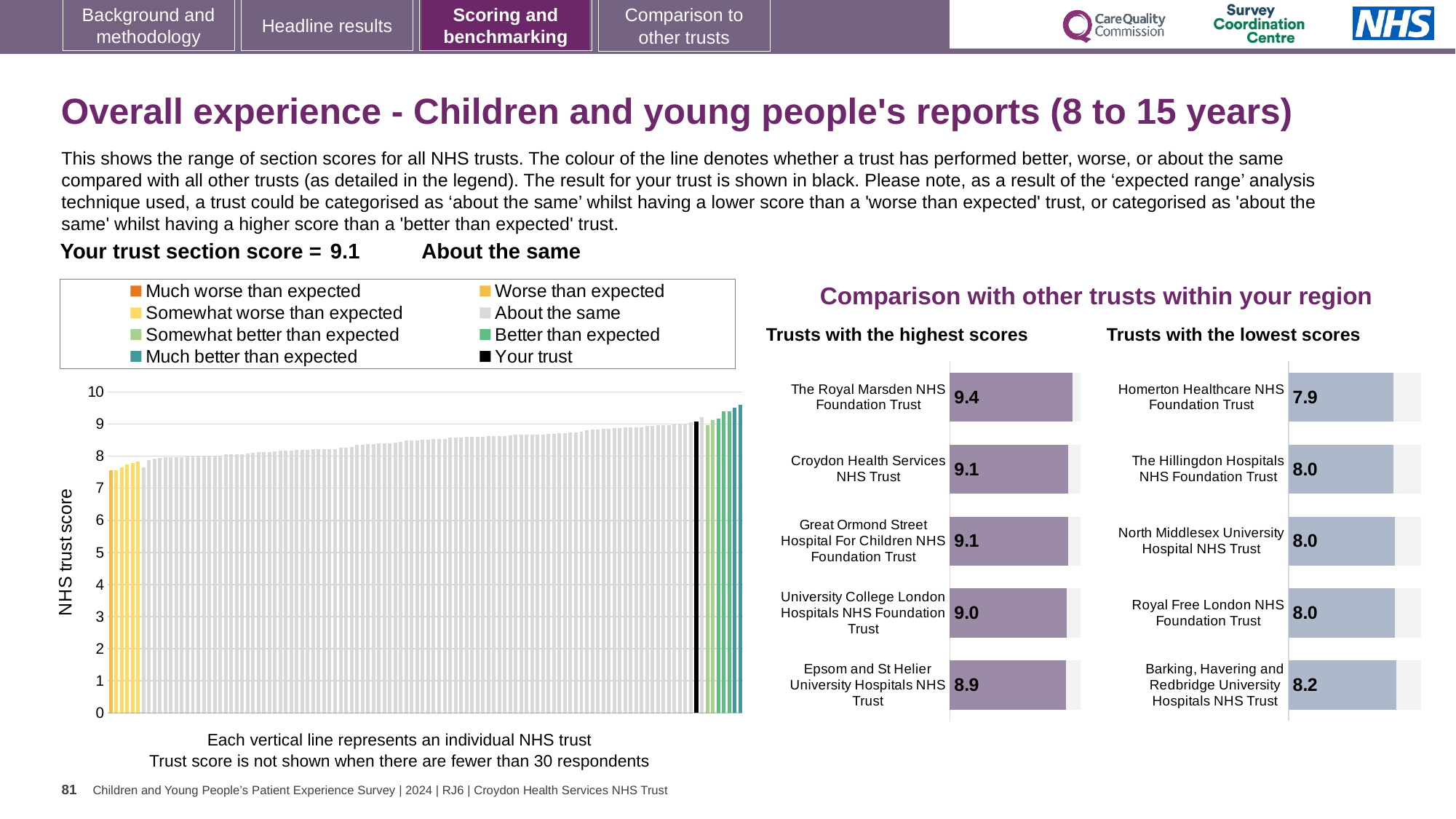
In the large chart on the left, is the value for the lowest-scoring trust greater or less than 8? less In the 'Trusts with the highest scores' chart, which trust has the highest score? The Royal Marsden NHS Foundation Trust In the 'Trusts with the highest scores' chart, what is the difference between the scores of The Royal Marsden NHS Foundation Trust and Epsom and St Helier University Hospitals NHS Trust? 0.5 In the 'Trusts with the lowest scores' chart, what is the score for Homerton Healthcare NHS Foundation Trust? 7.9 What kind of chart is the large chart on the left showing all NHS trusts? Bar chart In the 'Trusts with the lowest scores' chart, which trust has the lowest score? Homerton Healthcare NHS Foundation Trust How many entries does the legend of the large chart on the left list? 8 In the 'Trusts with the lowest scores' chart, what is the score for Barking, Havering and Redbridge University Hospitals NHS Trust? 8.2 In the 'Trusts with the lowest scores' chart, which has the larger score: Barking, Havering and Redbridge University Hospitals NHS Trust or Homerton Healthcare NHS Foundation Trust? Barking, Havering and Redbridge University Hospitals NHS Trust In the 'Trusts with the highest scores' chart, what is the score for The Royal Marsden NHS Foundation Trust? 9.4 How many trusts are shown in the 'Trusts with the lowest scores' chart? 5 In the 'Trusts with the highest scores' chart, what is the score for Epsom and St Helier University Hospitals NHS Trust? 8.9